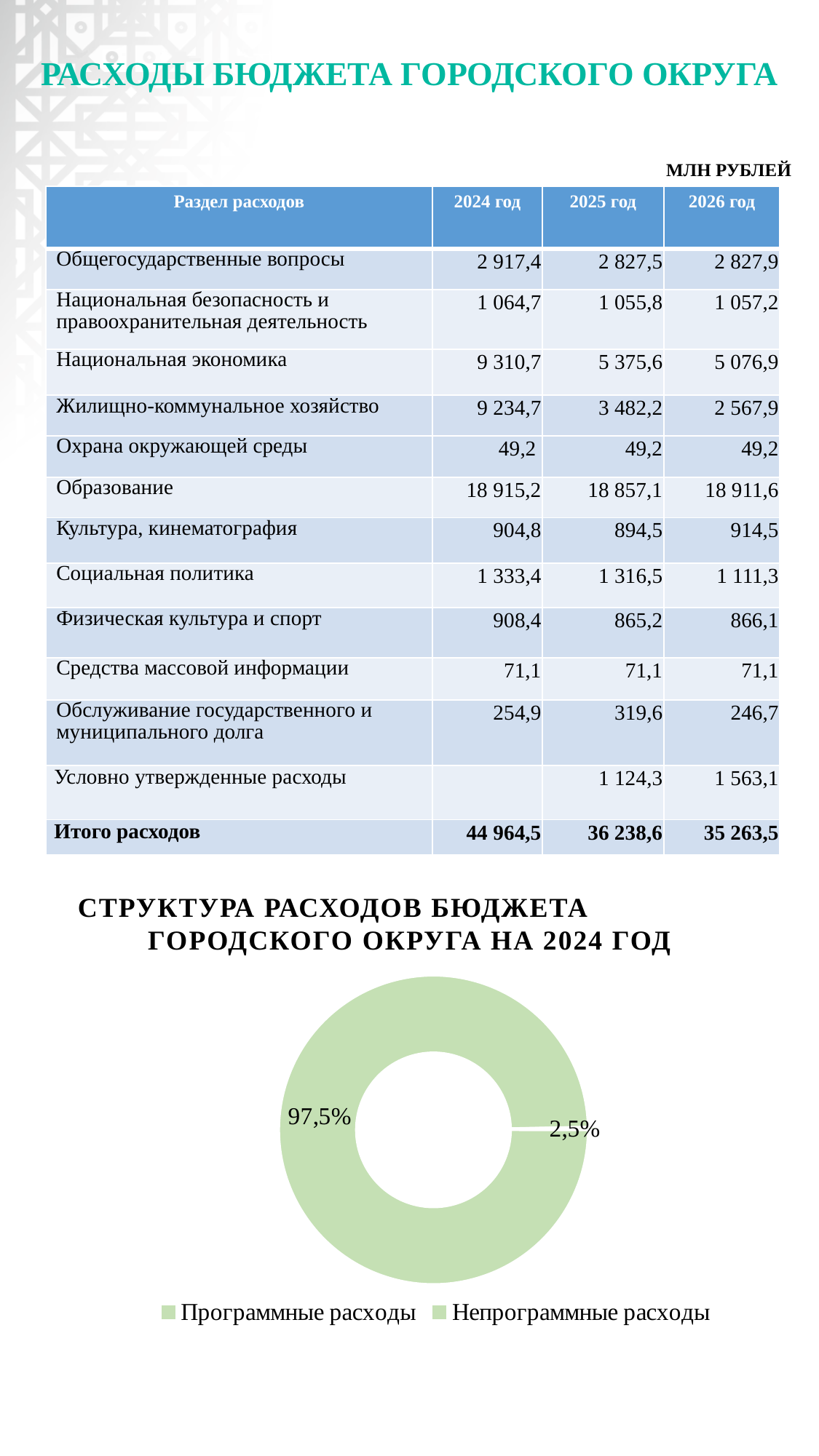
In the doughnut chart, which category has the smallest share? Непрограммные расходы What are the two legend entries of the doughnut chart? Программные расходы and Непрограммные расходы What kind of chart is shown under the title "СТРУКТУРА РАСХОДОВ БЮДЖЕТА ГОРОДСКОГО ОКРУГА НА 2024 ГОД"? Doughnut (pie) chart How many slices does the doughnut chart have? 2 In the doughnut chart, which is larger: Программные расходы or Непрограммные расходы? Программные расходы What is the title of the doughnut chart? СТРУКТУРА РАСХОДОВ БЮДЖЕТА ГОРОДСКОГО ОКРУГА НА 2024 ГОД In the doughnut chart, what is the difference in percentage points between Программные расходы and Непрограммные расходы? 95 percentage points In the doughnut chart, which category has the largest share? Программные расходы How many entries does the legend of the doughnut chart list? 2 In the doughnut chart, what share is labelled for Непрограммные расходы? 2,5% In the doughnut chart, what share is labelled for Программные расходы? 97,5%